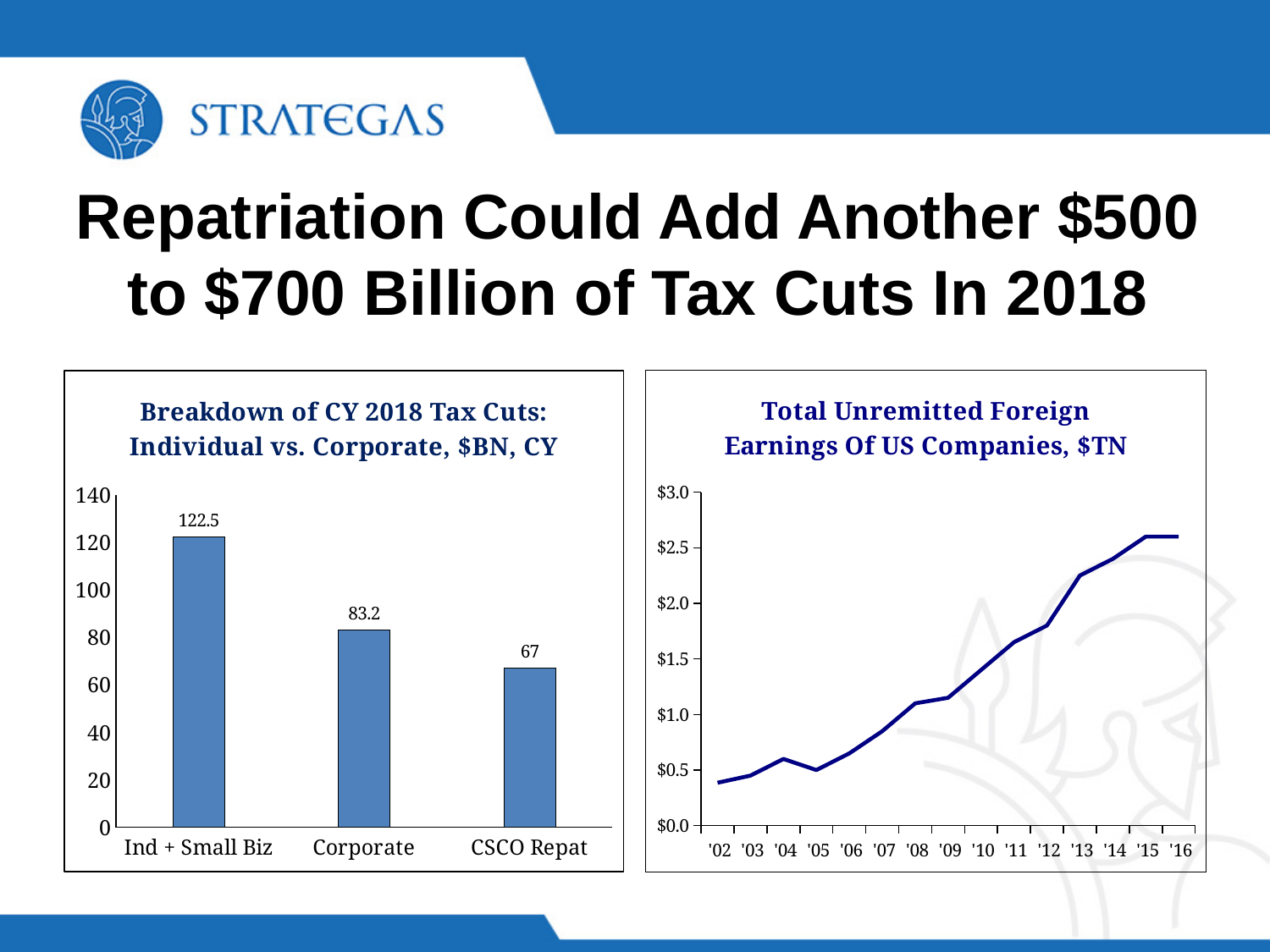
In the 'Breakdown of CY 2018 Tax Cuts' chart, what is the value for CSCO Repat? 67 In the 'Breakdown of CY 2018 Tax Cuts' chart, which category has the highest value? Ind + Small Biz In the 'Total Unremitted Foreign Earnings Of US Companies' chart, is the value for '16 greater or less than $2.5? greater In the 'Breakdown of CY 2018 Tax Cuts' chart, what is the value for Corporate? 83.2 What kind of chart is the 'Breakdown of CY 2018 Tax Cuts' chart? Bar chart In the 'Breakdown of CY 2018 Tax Cuts' chart, what is the value for Ind + Small Biz? 122.5 What kind of chart is the 'Total Unremitted Foreign Earnings Of US Companies' chart? Line chart In the 'Breakdown of CY 2018 Tax Cuts' chart, how many categories are shown? 3 In the 'Total Unremitted Foreign Earnings Of US Companies' chart, do the values generally rise or fall from '02 to '16? Rise In the 'Breakdown of CY 2018 Tax Cuts' chart, which category has the lowest value? CSCO Repat In the 'Breakdown of CY 2018 Tax Cuts' chart, what is the difference between the Ind + Small Biz and Corporate values? 39.3 In the 'Total Unremitted Foreign Earnings Of US Companies' chart, is the value for '02 greater or less than $0.5? less